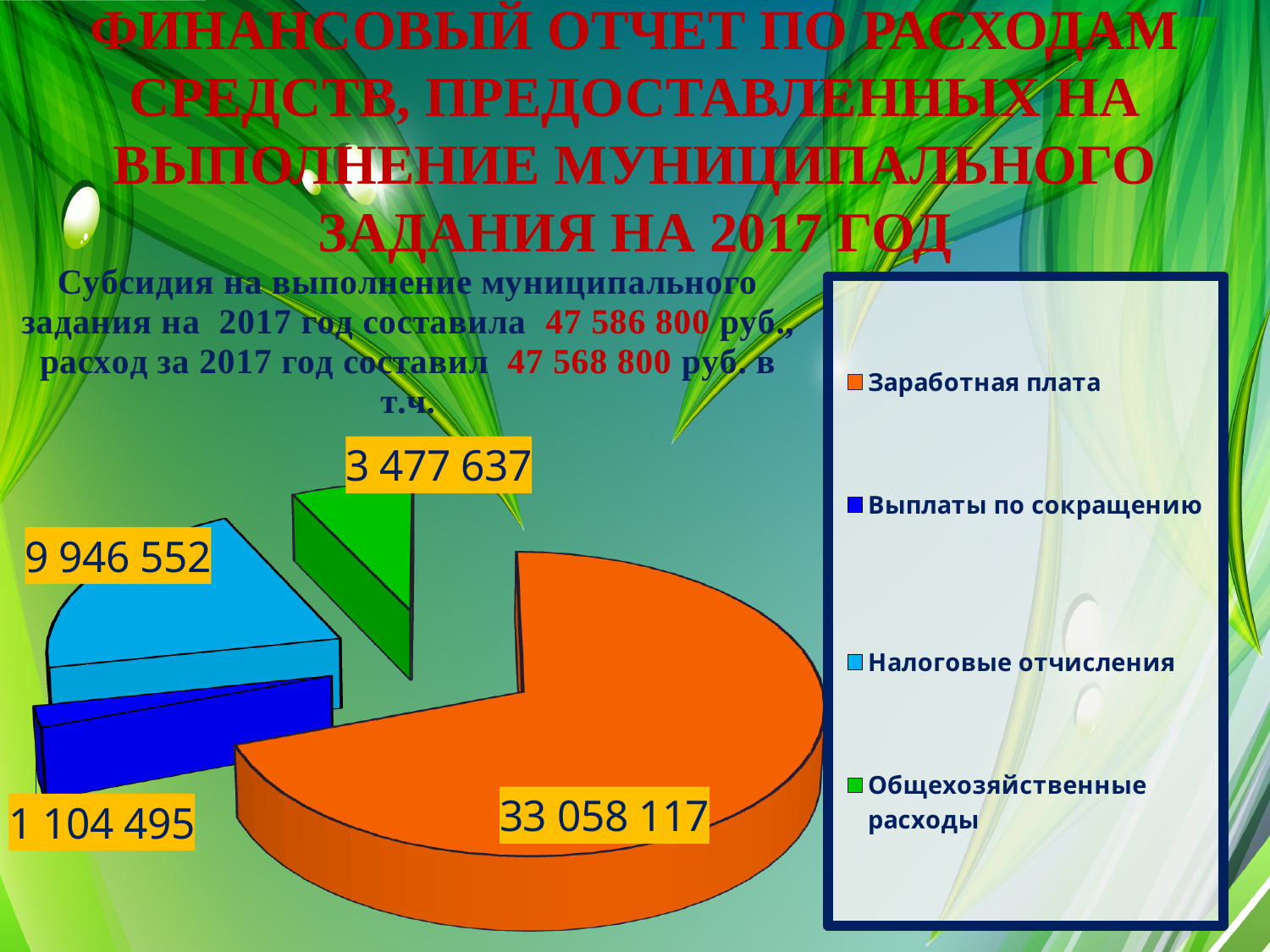
What colour is the slice for Заработная плата in the pie chart? Orange Which is larger in the pie chart: Налоговые отчисления or Общехозяйственные расходы? Налоговые отчисления What is the value for Заработная плата in the pie chart? 33 058 117 What is the value for Выплаты по сокращению in the pie chart? 1 104 495 Which category has the largest slice in the pie chart? Заработная плата What is the value for Налоговые отчисления in the pie chart? 9 946 552 How many categories does the legend of the pie chart list? 4 Which category has the smallest slice in the pie chart? Выплаты по сокращению How many slices does the pie chart have? 4 What is the difference between Заработная плата and Налоговые отчисления in the pie chart? 23 111 565 What is the value for Общехозяйственные расходы in the pie chart? 3 477 637 What type of chart is shown on the slide? Pie chart